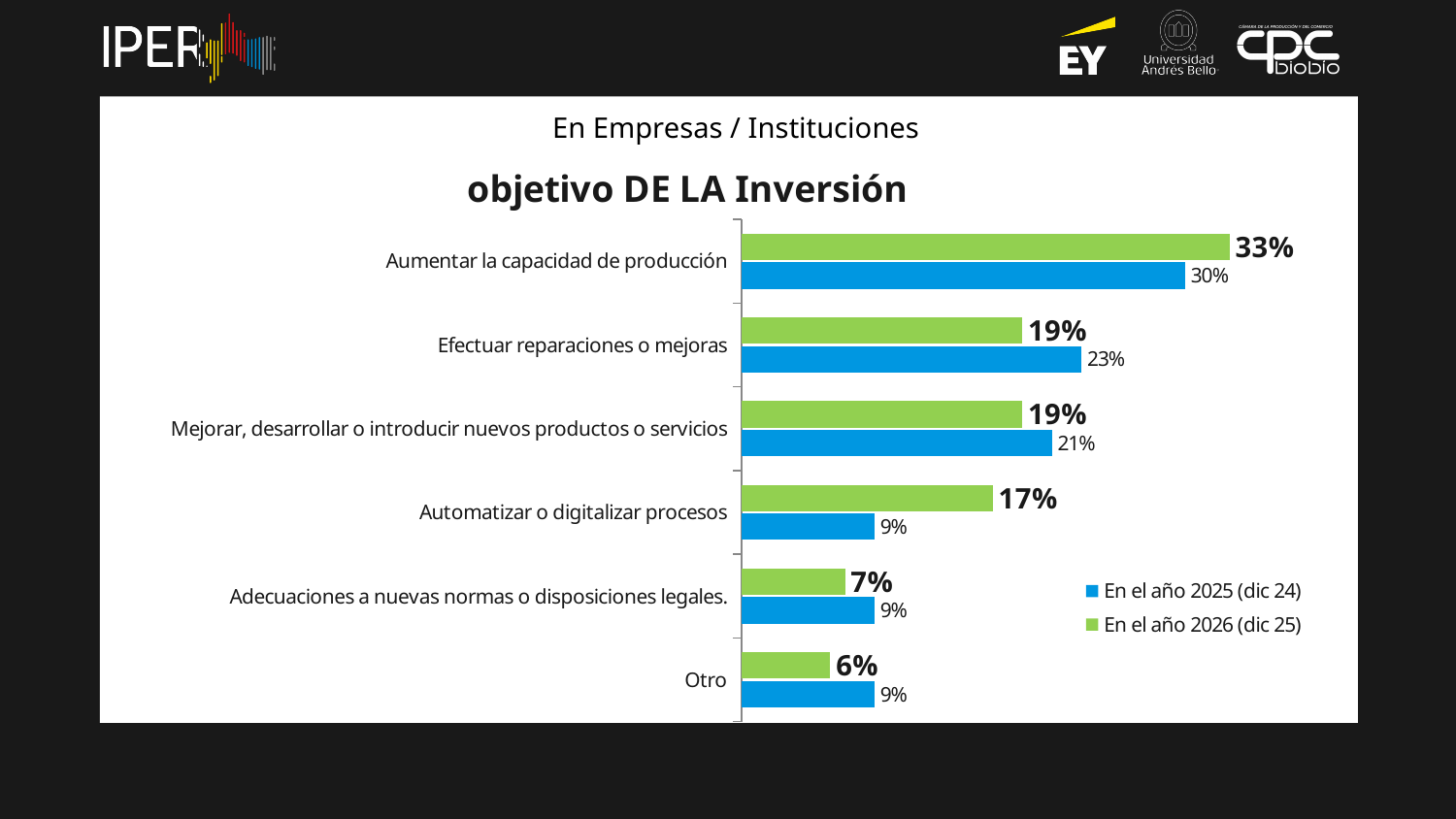
What is the value for "Efectuar reparaciones o mejoras" in the series "En el año 2025 (dic 24)"? 23% How many series does the legend list? 2 What is the value for "Automatizar o digitalizar procesos" in the series "En el año 2026 (dic 25)"? 17% For "Efectuar reparaciones o mejoras", which series has the larger value: "En el año 2025 (dic 24)" or "En el año 2026 (dic 25)"? En el año 2025 (dic 24) What is the value for "Otro" in the series "En el año 2025 (dic 24)"? 9% What is the difference between the 2026 (dic 25) and 2025 (dic 24) values for "Automatizar o digitalizar procesos"? 8% How many categories are shown in the chart? 6 What kind of chart is shown on the slide? bar chart What is the value for "Aumentar la capacidad de producción" in the series "En el año 2026 (dic 25)"? 33% Which category has the lowest value in the series "En el año 2026 (dic 25)"? Otro Which colour represents the series "En el año 2026 (dic 25)" in the chart? green Which category has the highest value in the series "En el año 2025 (dic 24)"? Aumentar la capacidad de producción